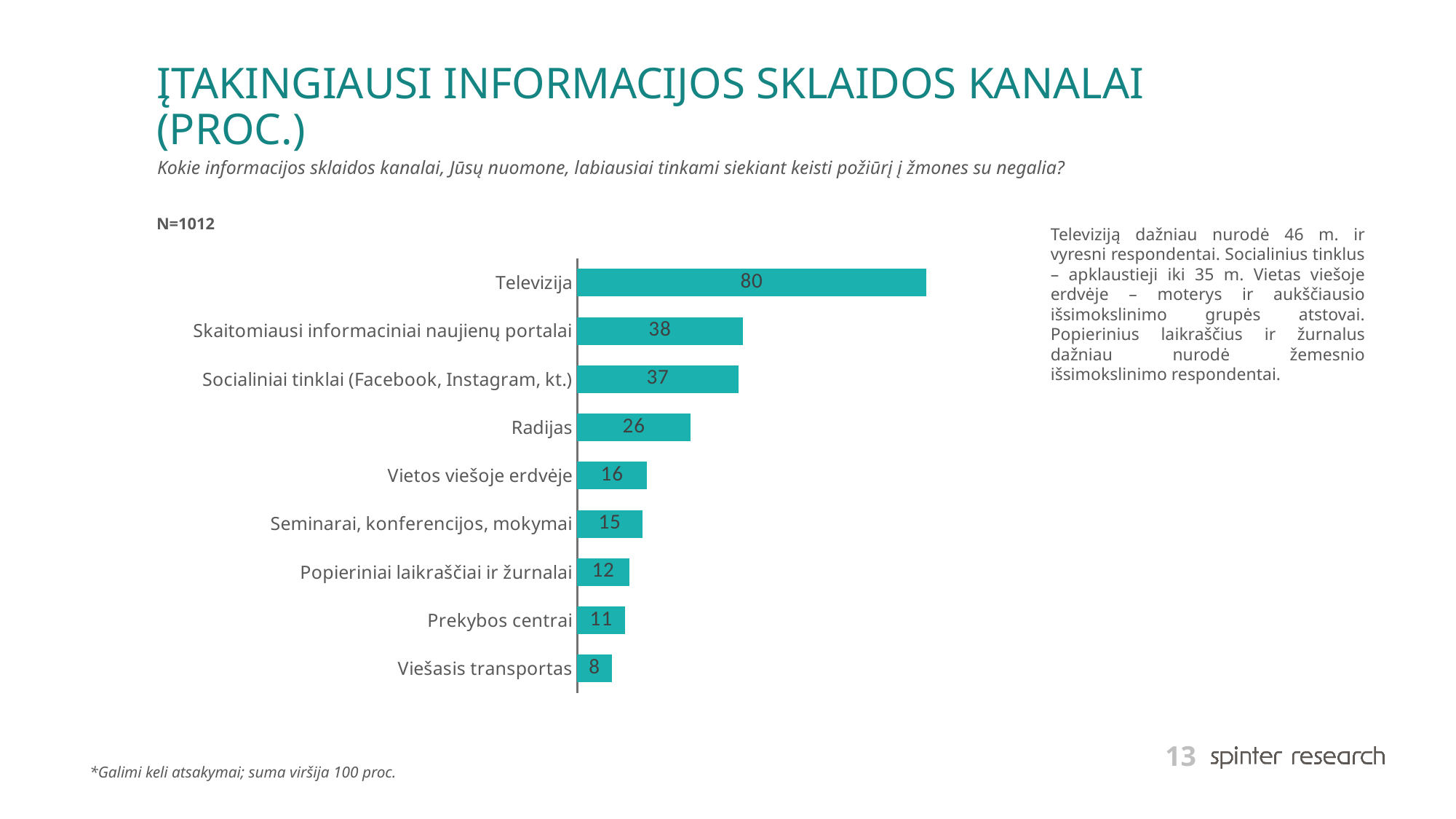
How many categories are shown in the chart? 9 What is the value for Radijas? 26 Which category has the highest value? Televizija Which is larger, the value for Seminarai, konferencijos, mokymai or the value for Prekybos centrai? Seminarai, konferencijos, mokymai What is the value for Popieriniai laikraščiai ir žurnalai? 12 What is the value for Socialiniai tinklai (Facebook, Instagram, kt.)? 37 Which category has the lowest value? Viešasis transportas What is the difference between the values for Radijas and Vietos viešoje erdvėje? 10 What kind of chart is shown on the slide? Bar chart What is the difference between the values for Televizija and Skaitomiausi informaciniai naujienų portalai? 42 What is the value for Televizija? 80 What is the sample size (N) stated on the slide? N=1012